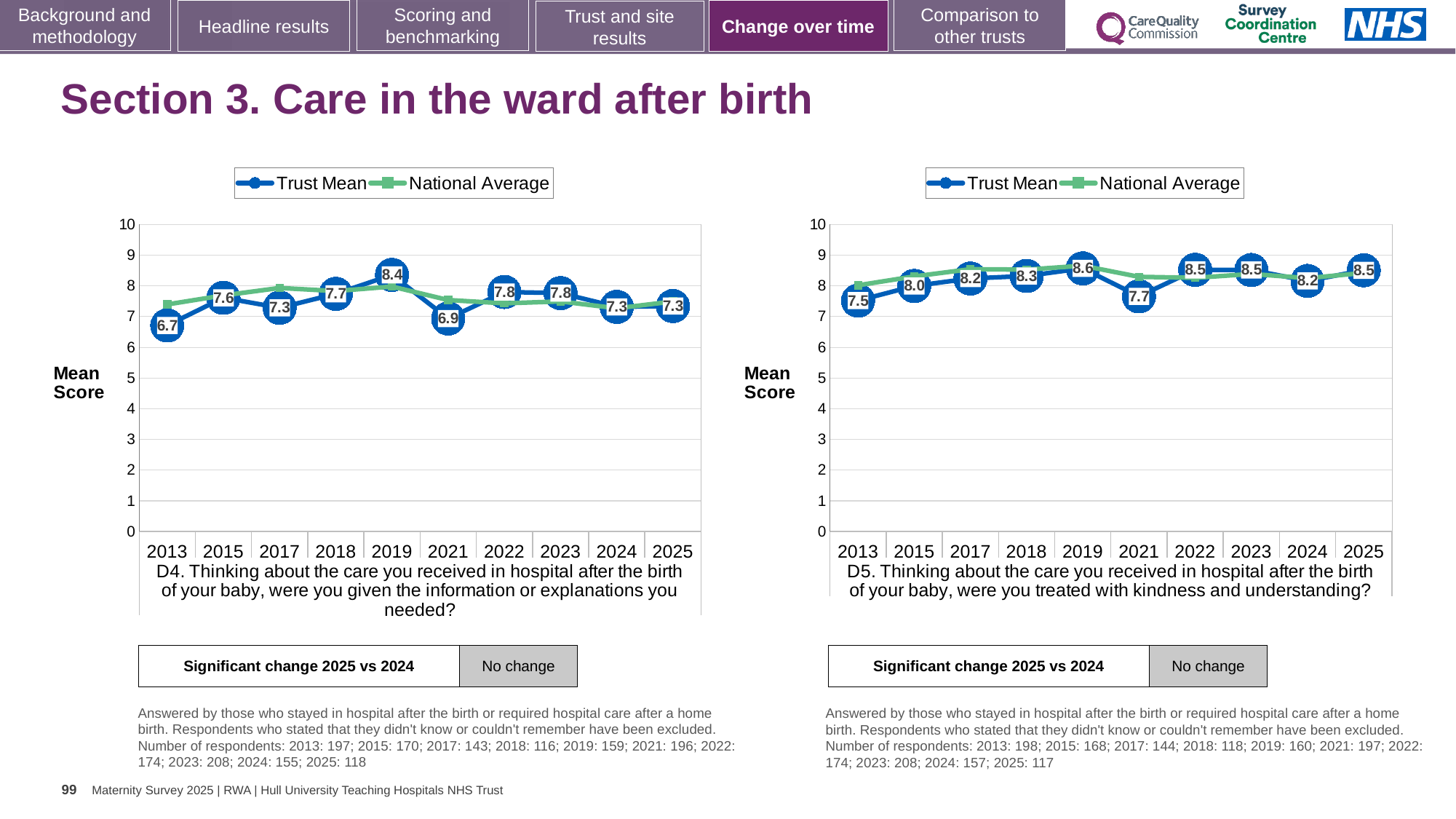
On the right chart (D5), which year has the highest Trust Mean score? 2019 What kind of chart is the left chart (D4)? line chart On the right chart (D5), what is the Trust Mean score for 2021? 7.7 How many years are plotted on the x axis of the left chart (D4)? 10 On the left chart (D4), what is the Trust Mean score for 2013? 6.7 On the left chart (D4), what is the Trust Mean score for 2019? 8.4 On the right chart (D5), which year has the lowest Trust Mean score? 2013 On the left chart (D4), which year has the highest Trust Mean score? 2019 How many series does the legend of the right chart (D5) list? 2 On the left chart (D4), what is the difference between the Trust Mean scores for 2019 and 2021? 1.5 On the left chart (D4), which year has the lowest Trust Mean score? 2013 On the right chart (D5), is the Trust Mean score for 2025 larger or smaller than the score for 2024? larger